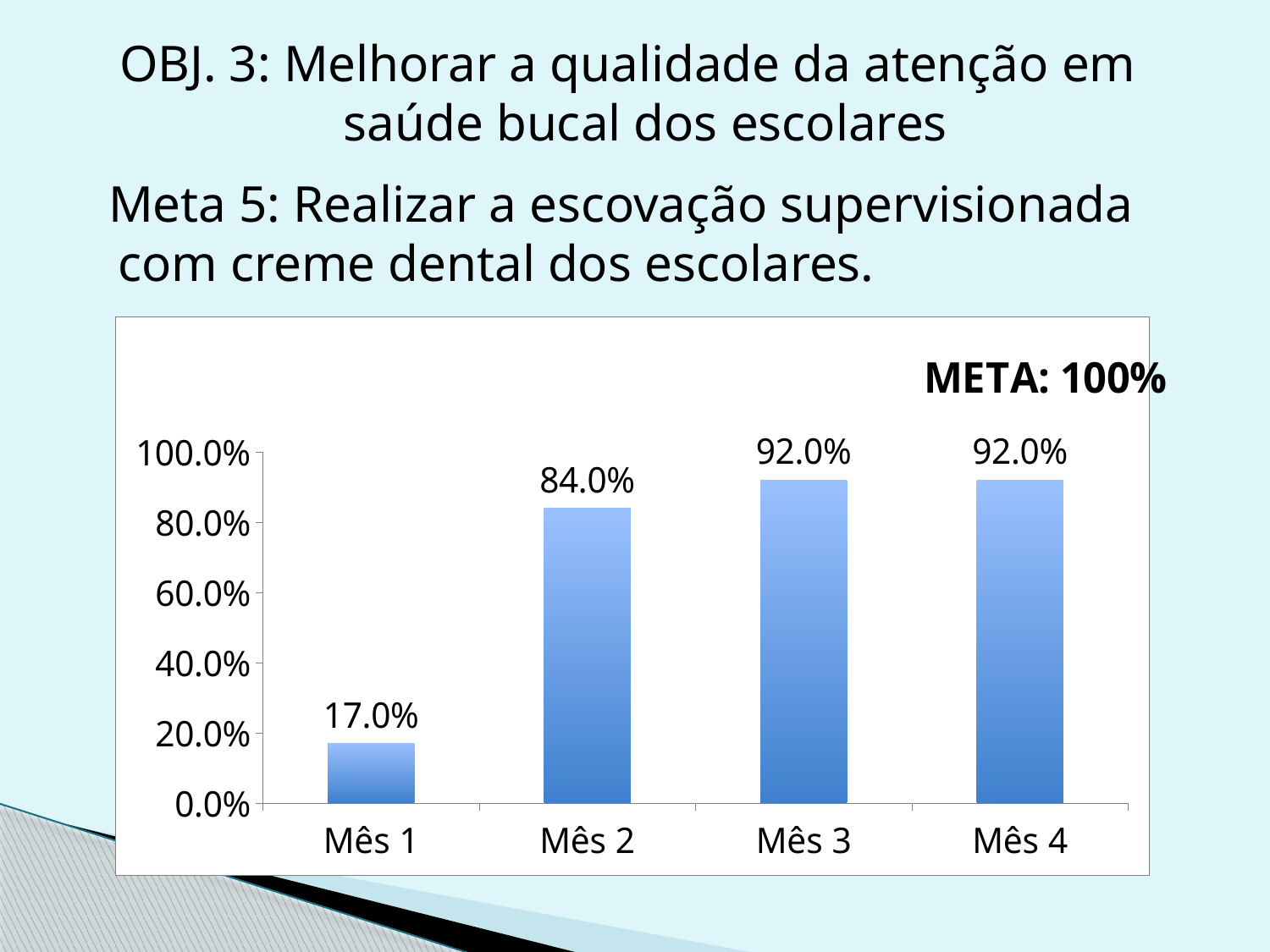
Do the values rise or fall from Mês 1 to Mês 3? Rise What is the difference between the values for Mês 3 and Mês 2? 8.0% What is the difference between the values for Mês 2 and Mês 1? 67.0% Is the value for Mês 2 greater or less than 80.0%? greater What is the value for Mês 1? 17.0% Which month has the lowest value? Mês 1 What is the value for Mês 2? 84.0% What is the value for Mês 3? 92.0% What target (META) is printed on the chart? 100% How many months are shown on the x axis? 4 Which is larger, the value for Mês 2 or the value for Mês 4? Mês 4 What kind of chart is shown on the slide? Bar chart